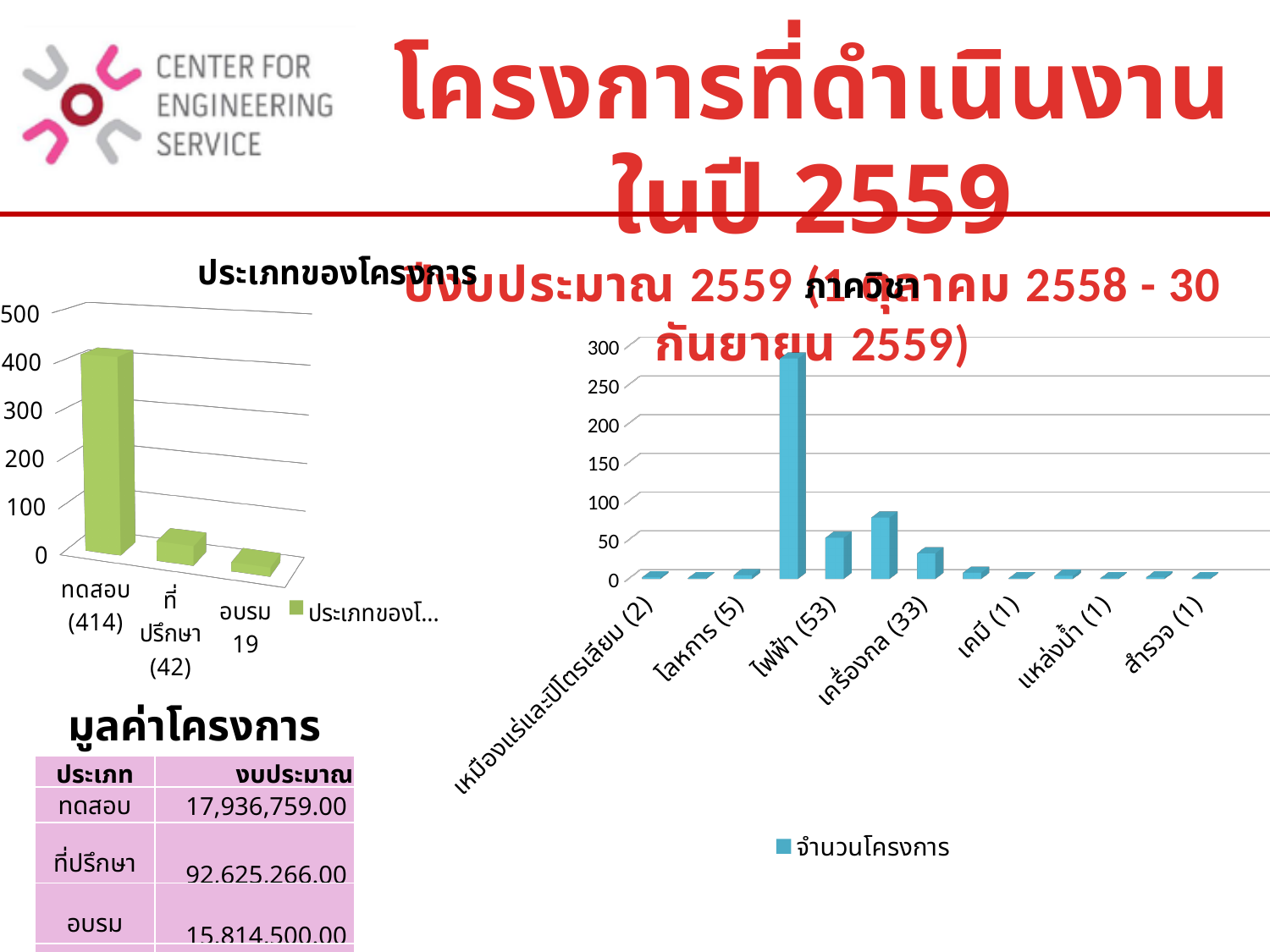
What kind of chart is the chart titled ประเภทของโครงการ? bar chart In the chart titled ภาควิชา, how many series does the legend list? 1 In the chart titled ประเภทของโครงการ, which category has the highest value? ทดสอบ In the chart titled ประเภทของโครงการ, what value is shown for ทดสอบ? 414 In the chart titled ประเภทของโครงการ, which category has the lowest value? อบรม In the chart titled ประเภทของโครงการ, what value is shown for อบรม? 19 In the chart titled ประเภทของโครงการ, how many categories are shown on the x axis? 3 In the chart titled ประเภทของโครงการ, what is the difference between the values for ทดสอบ and ที่ปรึกษา? 372 What kind of chart is the chart titled ภาควิชา? bar chart In the chart titled ประเภทของโครงการ, what value is shown for ที่ปรึกษา? 42 In the chart titled ประเภทของโครงการ, is the value for ทดสอบ greater or less than 400? greater In the chart titled ภาควิชา, what is the legend entry? จำนวนโครงการ